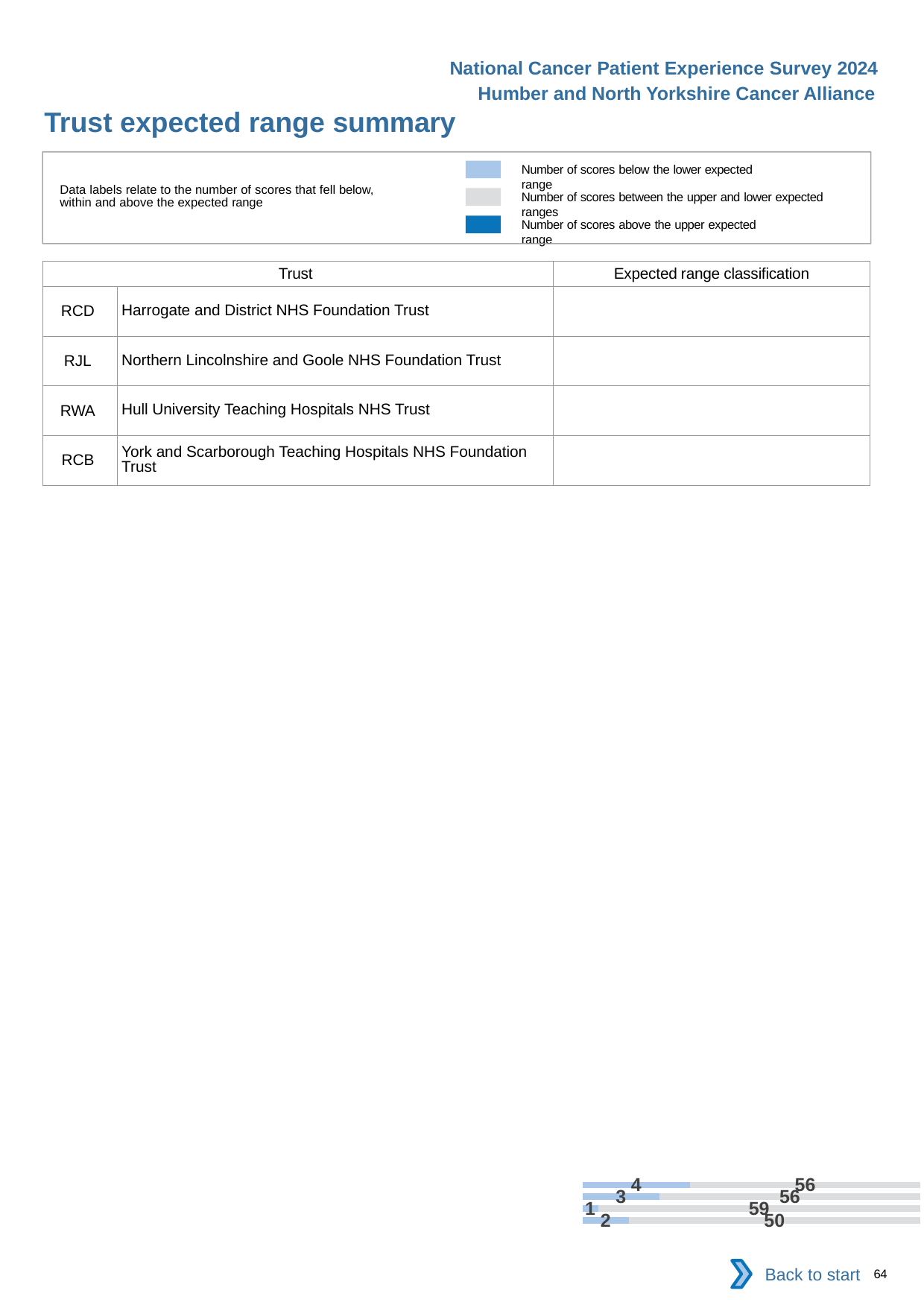
In the chart at the bottom of the slide, what is the highest grey (between expected ranges) data label? 59 In the chart at the bottom of the slide, what is the light-blue data label on the top bar? 4 In the chart at the bottom of the slide, what is the grey data label on the bottom bar? 50 How many bars are plotted in the chart at the bottom of the slide? 4 How many series does the legend at the top of the slide list? 3 In the chart at the bottom of the slide, what is the lowest grey (between expected ranges) data label? 50 According to the legend, what does the dark blue colour represent? Number of scores above the upper expected range In the chart at the bottom of the slide, what is the difference between the highest grey label (59) and the lowest grey label (50)? 9 What kind of chart appears at the bottom of the slide? bar chart In the chart at the bottom of the slide, what is the highest light-blue (below lower expected range) data label? 4 In the chart at the bottom of the slide, what is the lowest light-blue (below lower expected range) data label? 1 According to the legend, what does the light blue colour represent? Number of scores below the lower expected range